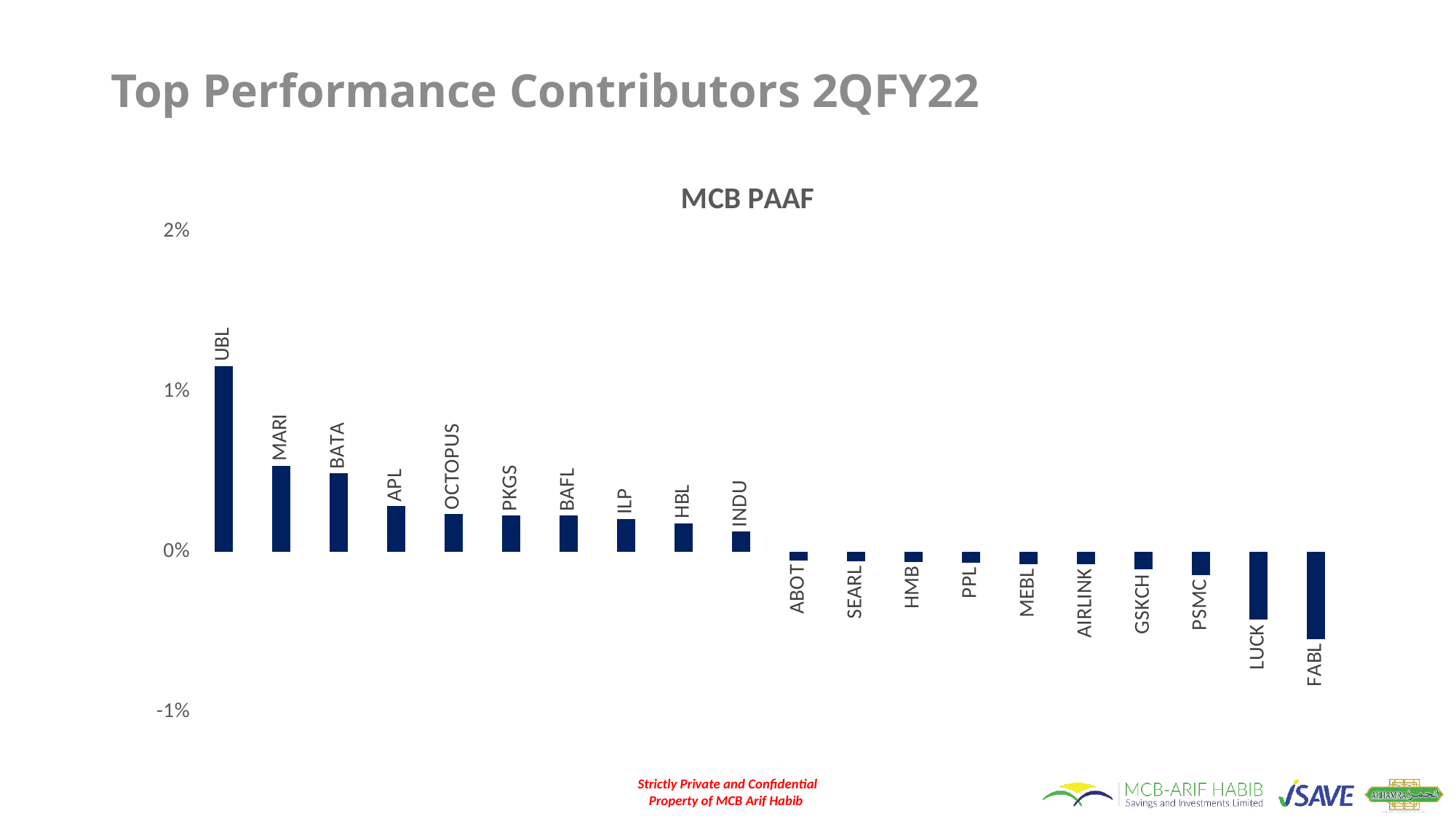
Which category has the highest value? UBL What is the title of the chart? MCB PAAF Which is larger, the value for LUCK or the value for FABL? LUCK Is the value for ABOT greater or less than 0%? less Is the value for FABL greater or less than -1%? greater Is the value for MARI greater or less than 1%? less Do the values rise or fall moving from left to right along the x axis? Fall What kind of chart is shown on the slide? Bar chart Which category has the lowest value? FABL How many categories are plotted in the chart? 20 Which is larger, the value for UBL or the value for MARI? UBL